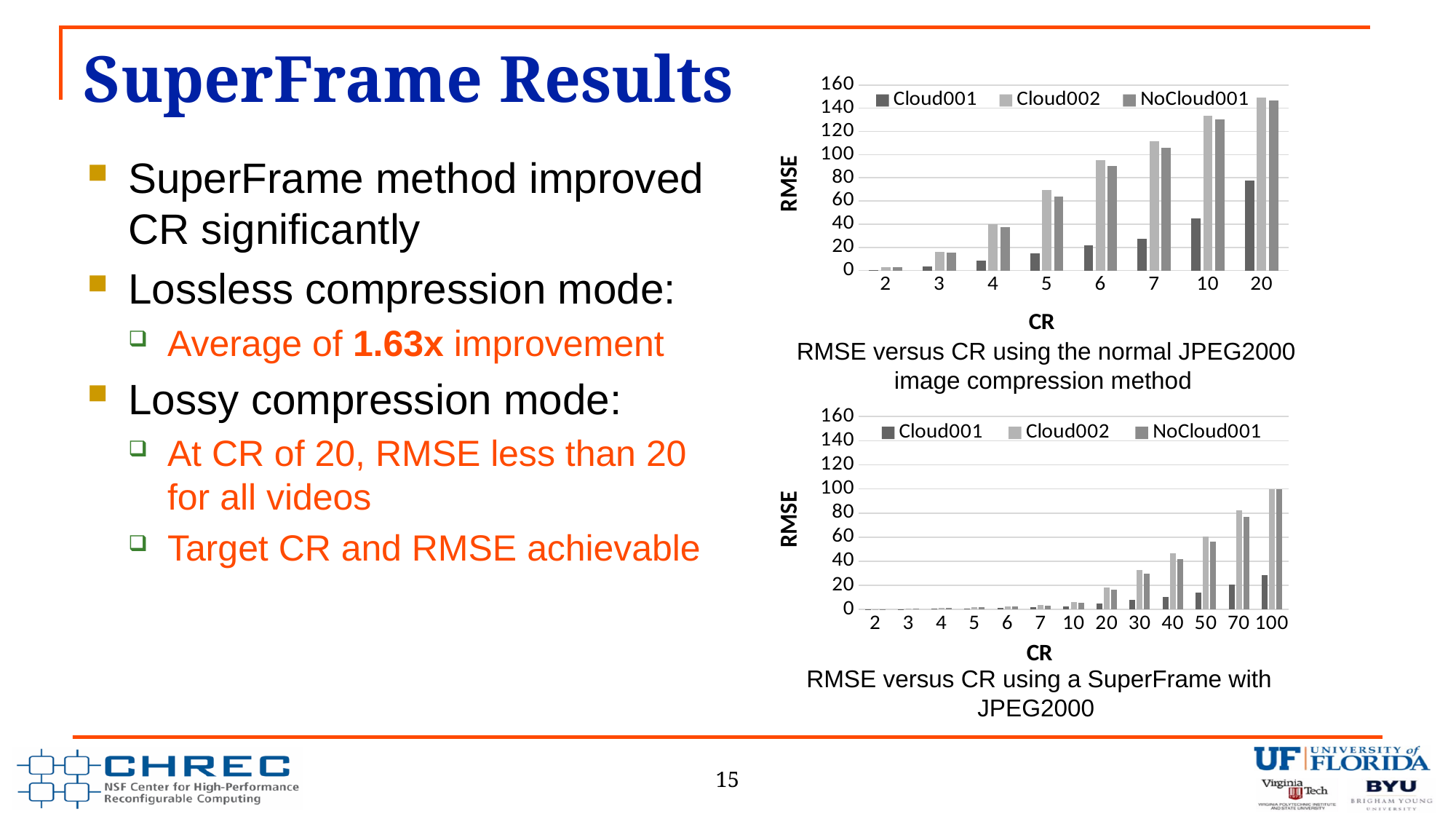
In the bottom chart (SuperFrame with JPEG2000), is the RMSE for Cloud002 at CR 70 greater or less than 60? greater How many CR categories are shown on the x axis of the top chart (normal JPEG2000)? 8 In the bottom chart (SuperFrame with JPEG2000), is the RMSE for Cloud001 at CR 100 greater or less than 40? less In the bottom chart (SuperFrame with JPEG2000), do the RMSE values rise or fall as CR increases along the x axis? rise In the top chart (normal JPEG2000), is the RMSE for Cloud002 at CR 20 greater or less than 140? greater In the bottom chart (SuperFrame with JPEG2000), at which CR does Cloud001 reach its highest RMSE? 100 What type of chart is the top chart, 'RMSE versus CR using the normal JPEG2000 image compression method'? bar chart In the top chart (normal JPEG2000), at CR 20, which series has the larger RMSE: Cloud001 or Cloud002? Cloud002 How many CR categories are shown on the x axis of the bottom chart (SuperFrame with JPEG2000)? 13 How many series does the legend of the top chart (normal JPEG2000) list? 3